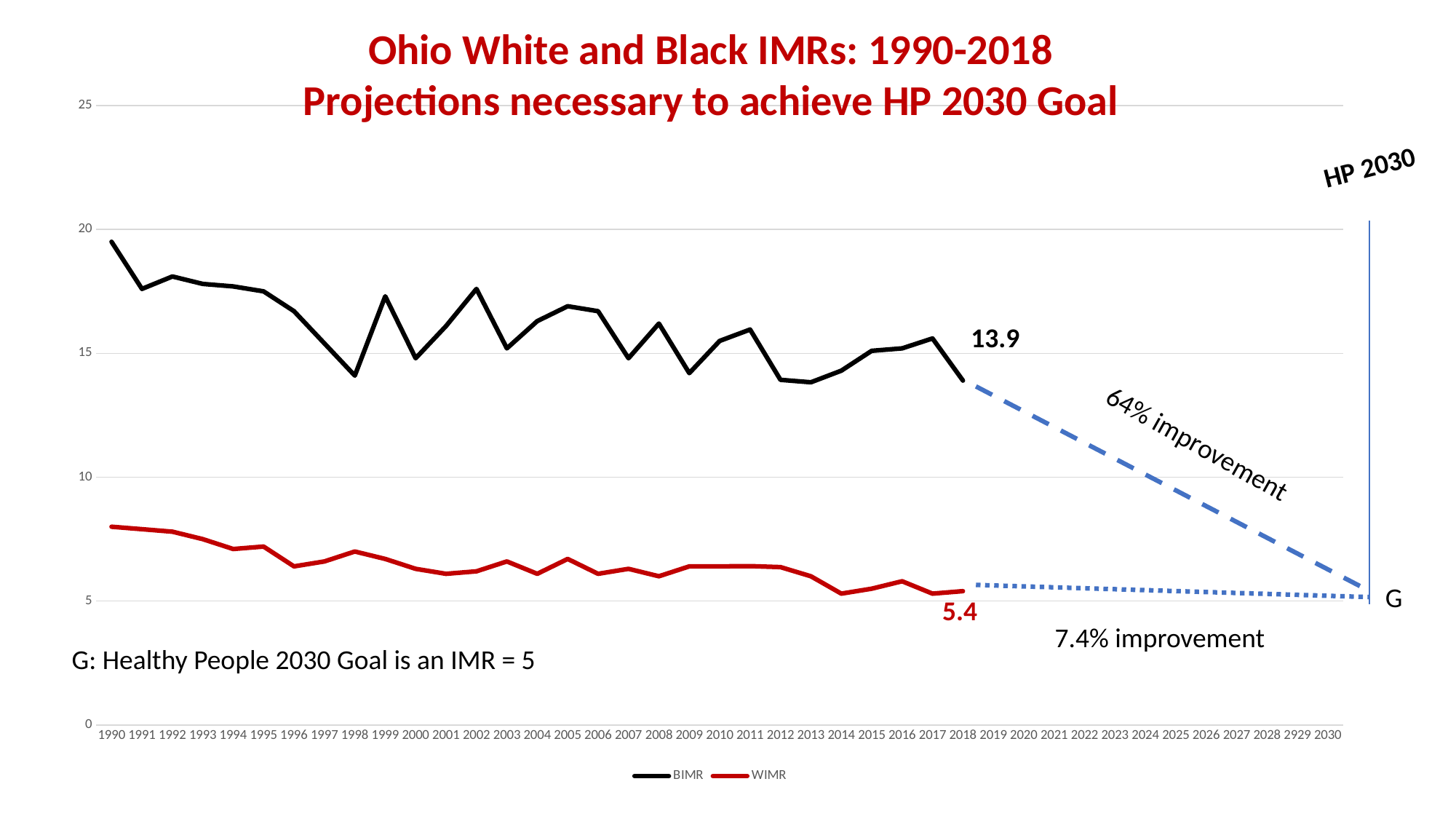
What kind of chart is shown on the slide? line chart Is the WIMR value for 1990 greater or less than 10? less Does the BIMR series generally rise or fall from 1990 to 2018? fall In which year is the BIMR series at its highest? 1990 How many series does the legend list? 2 According to the note on the slide, what IMR is the Healthy People 2030 Goal? 5 What percentage improvement is annotated for the BIMR projection to reach the HP 2030 goal? 64% improvement What is the BIMR value labelled for 2018? 13.9 What is the difference between the labelled 2018 BIMR and WIMR values? 8.5 Is the BIMR value for 1990 greater or less than 15? greater Which series has the larger value in 2018, BIMR or WIMR? BIMR What is the WIMR value labelled for 2018? 5.4